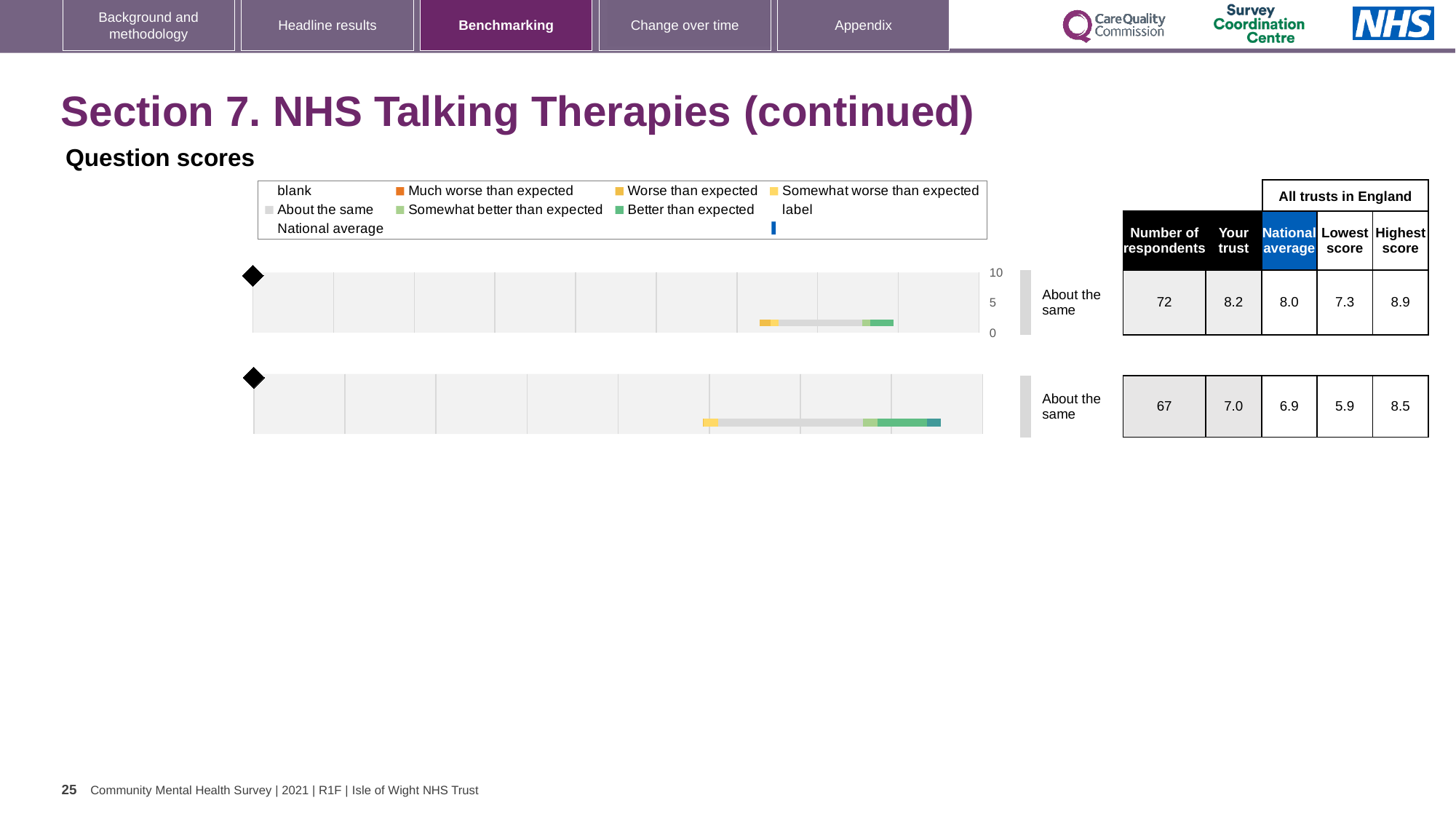
In the top chart's row of the table, what is the number of respondents? 72 In the bottom chart's row of the table, what is the number of respondents? 67 In the bottom chart's row of the table, what is the lowest score among all trusts in England? 5.9 What benchmark category is shown next to both charts? About the same For the top chart's row, which is larger: the 'Your trust' score or the national average? Your trust In the top chart's row of the table, what is the highest score among all trusts in England? 8.9 In the top chart's row of the table, what is the 'Your trust' score? 8.2 For the bottom chart's row, what is the difference between the highest score and the lowest score? 2.6 In the bottom chart's row of the table, what is the 'Your trust' score? 7.0 For the top chart's row, what is the difference between the highest score and the lowest score? 1.6 What kind of chart is used to show the question scores on this slide? Bar chart In the top chart's row of the table, what is the national average score? 8.0